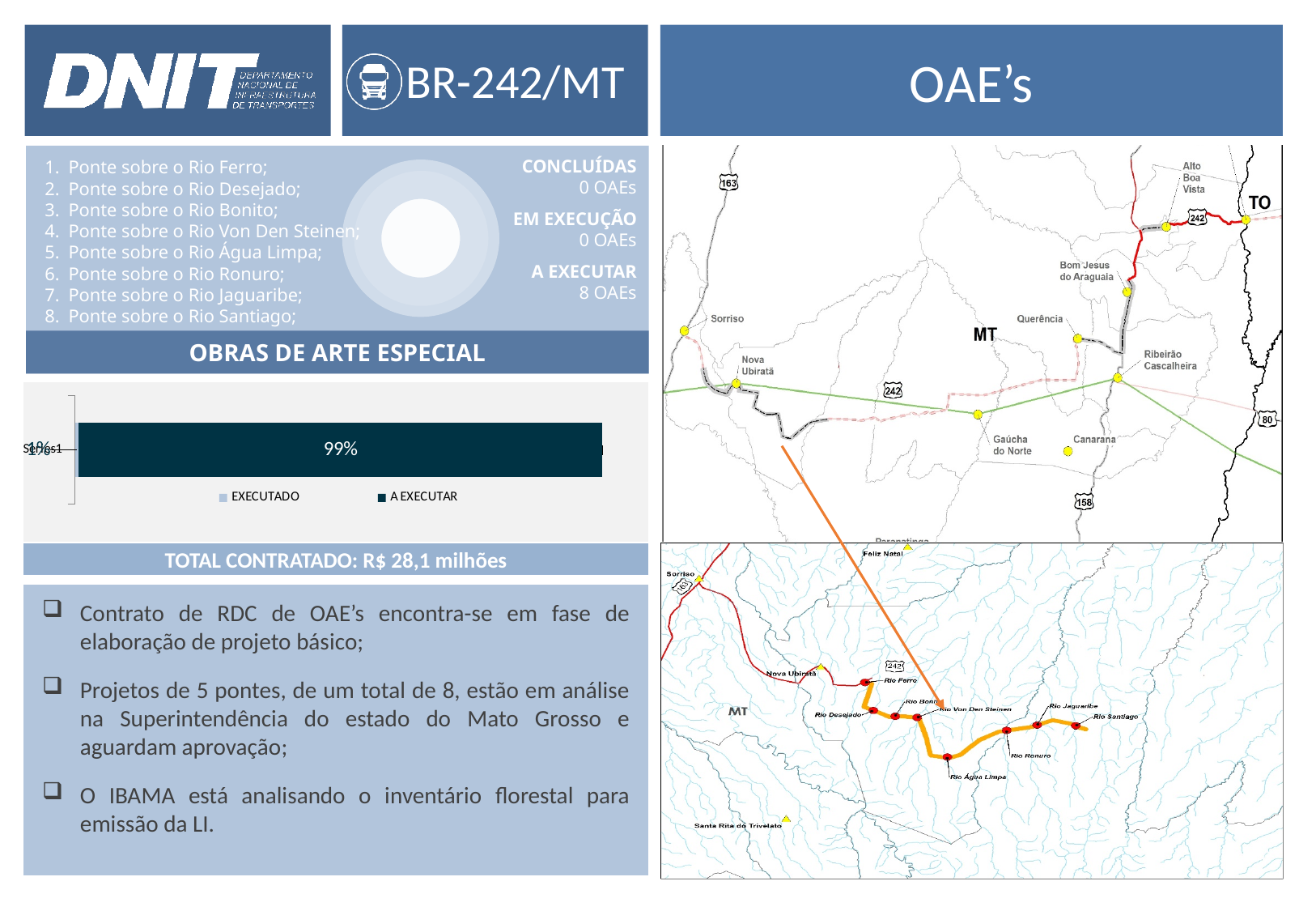
What kind of chart is shown below the 'OBRAS DE ARTE ESPECIAL' heading? bar chart How many series does the legend of the bar chart list? 2 Which series occupies the largest portion of the bar in the chart? A EXECUTAR Which series occupies the smallest portion of the bar in the chart? EXECUTADO What value is labelled on the A EXECUTAR segment of the bar chart? 99% Which series has the larger share of the bar in the chart, EXECUTADO or A EXECUTAR? A EXECUTAR How many bars are plotted in the chart? 1 Which series in the bar chart is drawn in dark navy? A EXECUTAR What are the two legend entries of the bar chart? EXECUTADO and A EXECUTAR